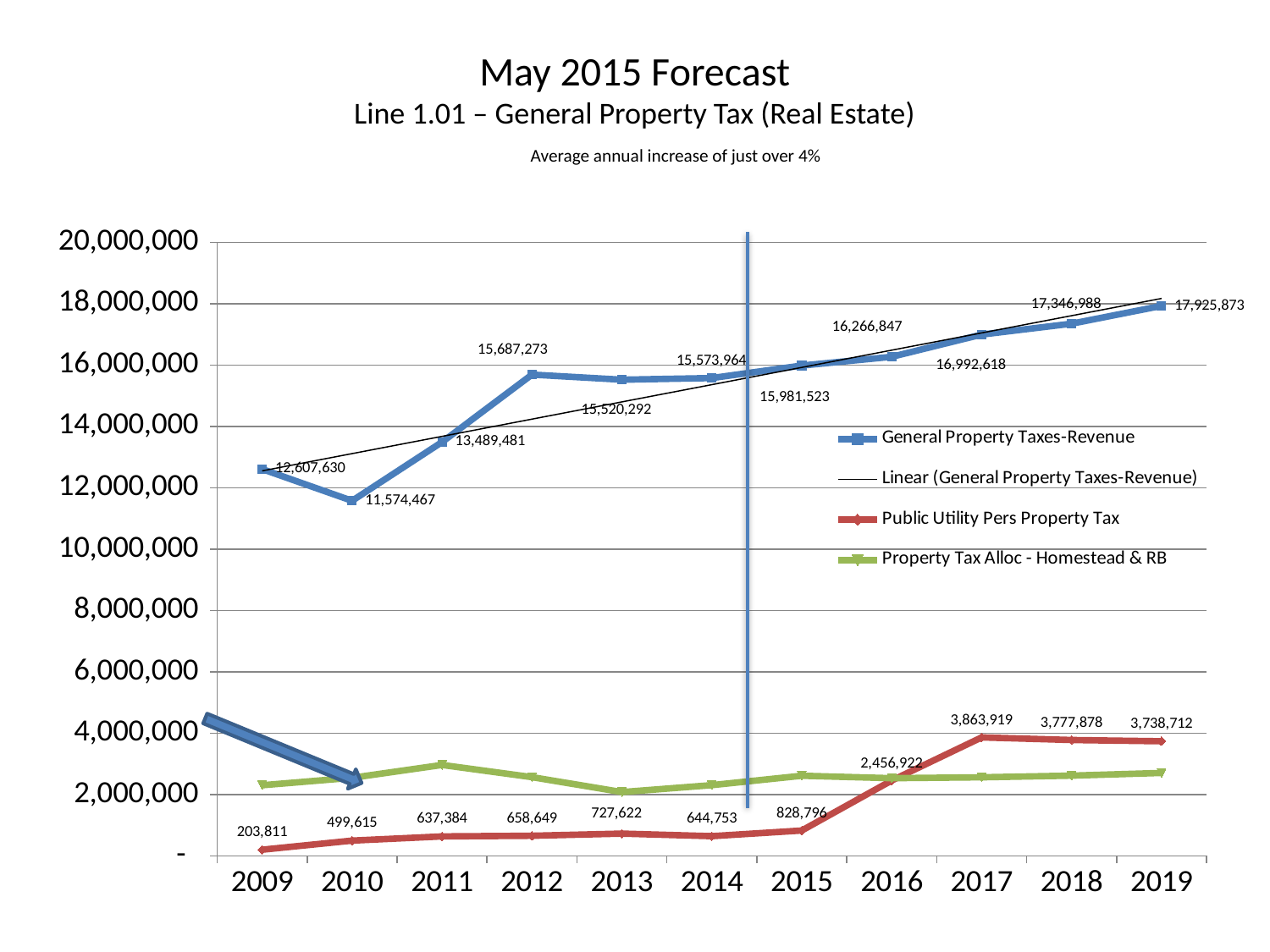
Does Public Utility Pers Property Tax rise or fall from 2015 to 2017? rise How many entries does the legend list? 4 Which year has the larger Public Utility Pers Property Tax value, 2017 or 2018? 2017 What is the General Property Taxes-Revenue value for 2019? 17,925,873 What is the Public Utility Pers Property Tax value for 2017? 3,863,919 In which year is General Property Taxes-Revenue lowest? 2010 How much higher is General Property Taxes-Revenue in 2019 than in 2009? 5,318,243 In which year is General Property Taxes-Revenue highest? 2019 Is the Property Tax Alloc - Homestead & RB value for 2011 greater or less than 2,000,000? greater How many years are shown on the x axis? 11 What kind of chart is shown on the slide? line chart By how much did Public Utility Pers Property Tax increase from 2016 to 2017? 1,406,997